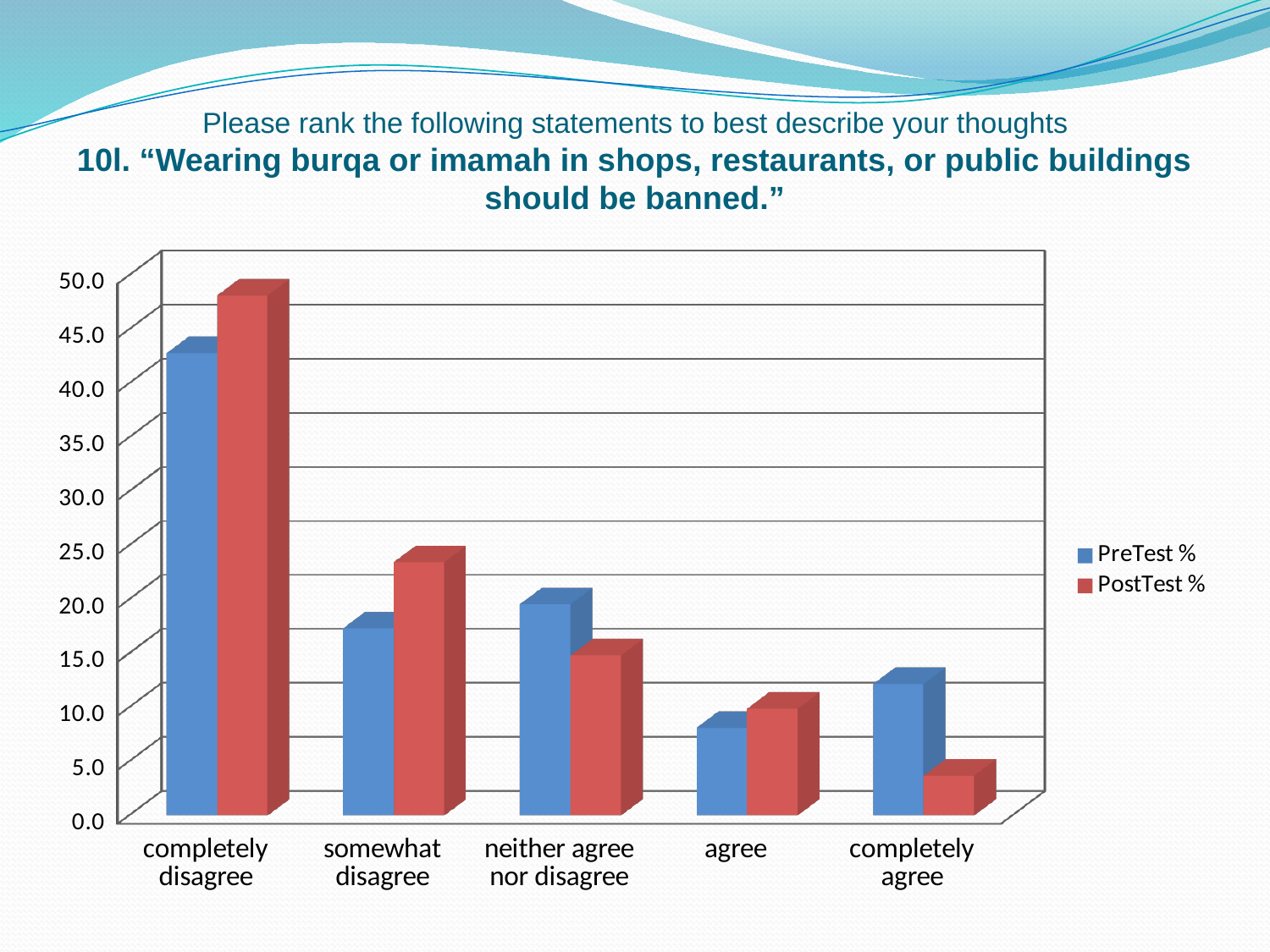
Is the PreTest % value for completely disagree greater or less than 40.0? greater For completely agree, which is larger: PreTest % or PostTest %? PreTest % Is the PostTest % value for completely agree greater or less than 5.0? less Which category has the lowest PostTest % value? completely agree For somewhat disagree, which is larger: PreTest % or PostTest %? PostTest % How many series does the legend list? 2 Which category has the highest PostTest % value? completely disagree Which category has the lowest PreTest % value? agree What kind of chart is shown on the slide? bar chart Which colour represents the PostTest % series in the legend? red How many response categories are shown on the x axis? 5 Is the PostTest % value for completely disagree greater or less than 45.0? greater